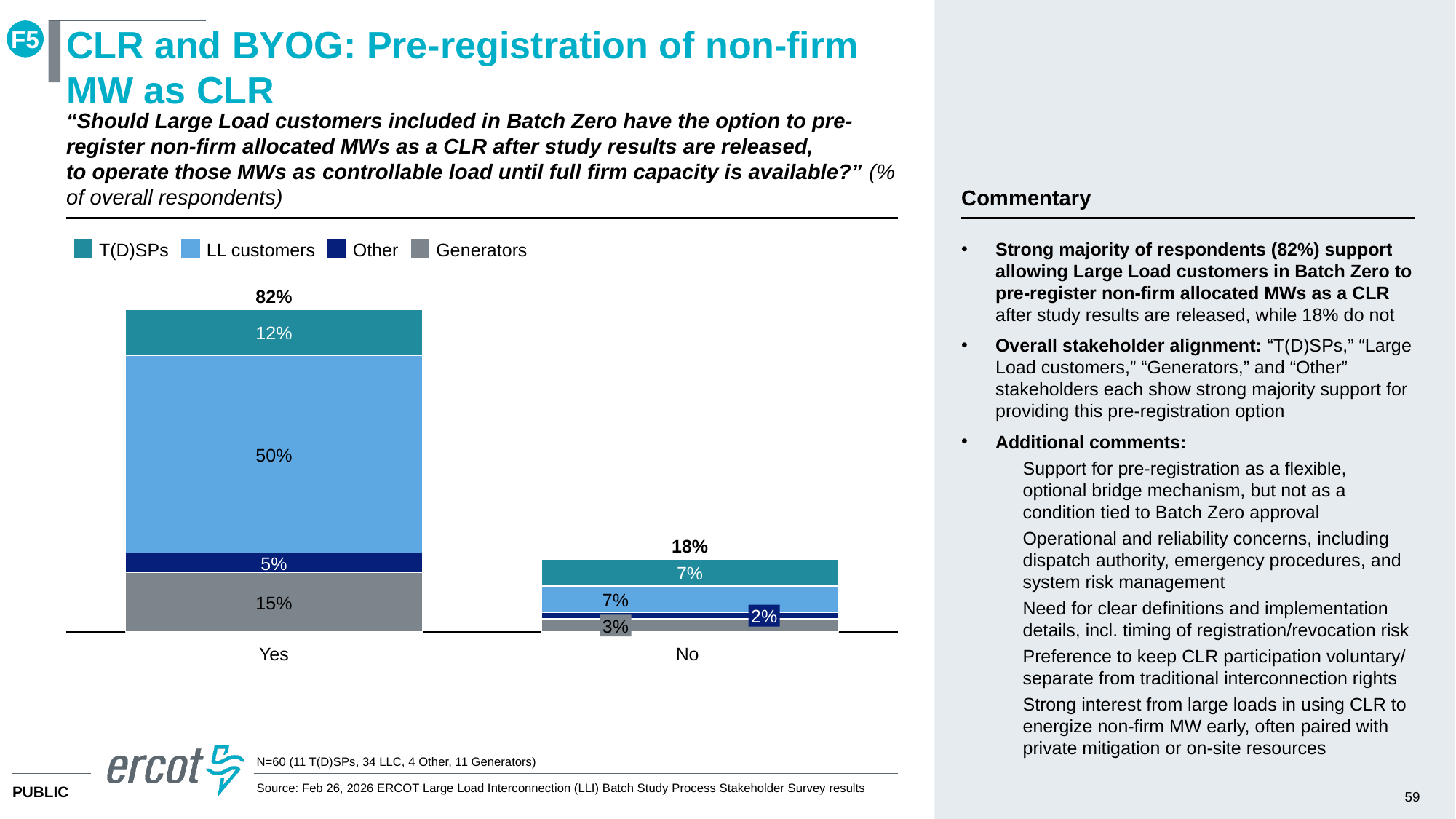
What is the total for the Yes bar? 82% What is the difference between the Yes total and the No total? 64% Which category has the higher total, Yes or No? Yes What is the value for Other in the No bar? 2% What kind of chart is shown on the slide? Stacked bar chart How many categories are shown on the x axis? 2 What is the total for the No bar? 18% What is the value for T(D)SPs in the No bar? 7% What is the difference between the T(D)SPs value in the Yes bar and the T(D)SPs value in the No bar? 5% How many series does the legend list? 4 What is the value for Generators in the Yes bar? 15% What is the value for LL customers in the Yes bar? 50%